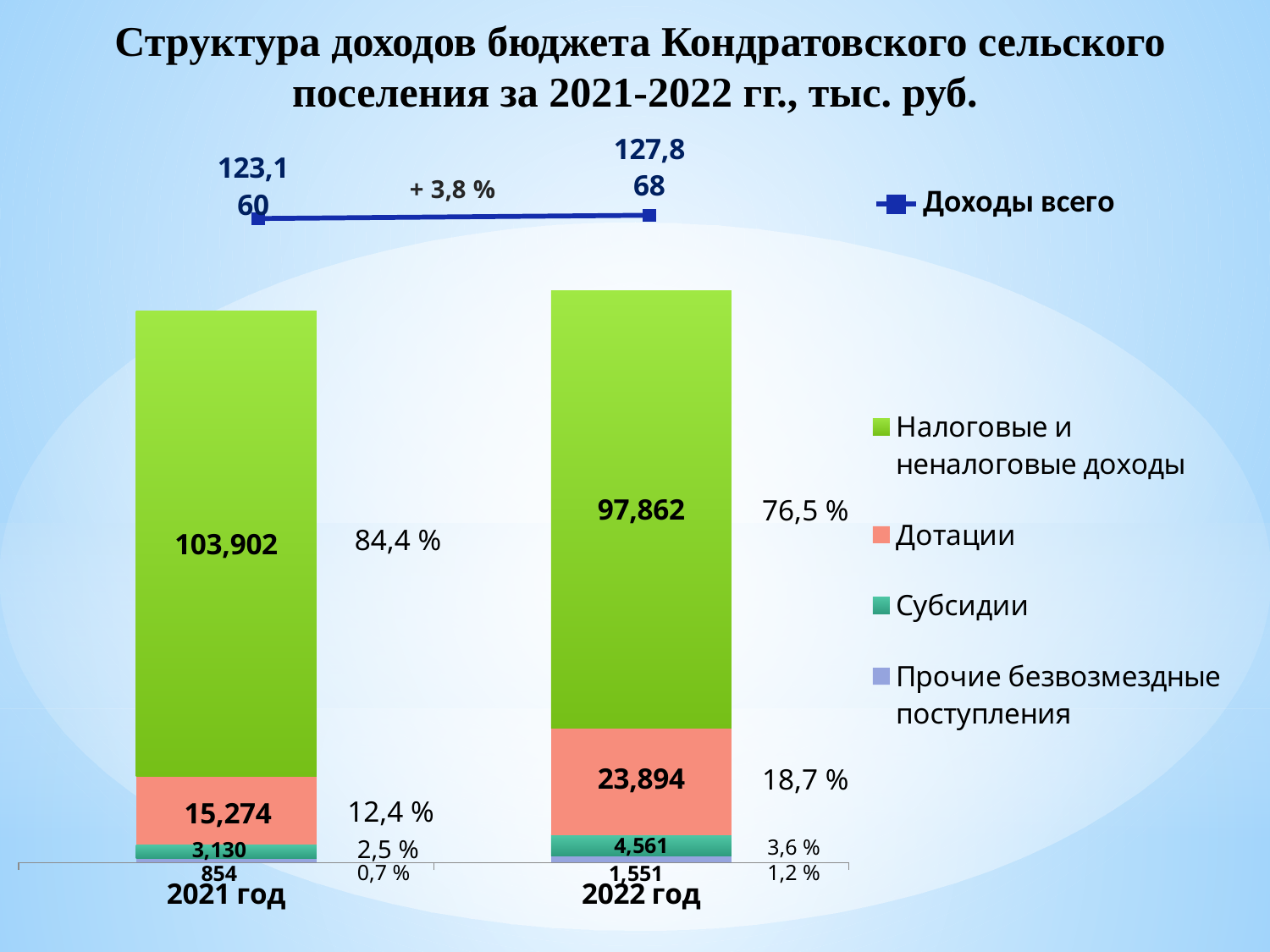
What share of the 2022 год total do Налоговые и неналоговые доходы make up, as labelled on the slide? 76,5 % How many series does the legend for the stacked bars list? 4 What is the total of the stacked bar for 2022 год (Доходы всего)? 127,868 Which segment is the smallest in the 2021 год bar? Прочие безвозмездные поступления What is the value of Дотации for 2022 год? 23,894 What is the value of Субсидии for 2021 год? 3,130 What is the value of Налоговые и неналоговые доходы for 2021 год? 103,902 What is the value of Прочие безвозмездные поступления for 2022 год? 1,551 What is the difference between Дотации in 2022 год and Дотации in 2021 год? 8,620 What type of chart is shown on the slide? Stacked bar chart Which year has the larger value for Налоговые и неналоговые доходы, 2021 год or 2022 год? 2021 год What is the total of the stacked bar for 2021 год (Доходы всего)? 123,160